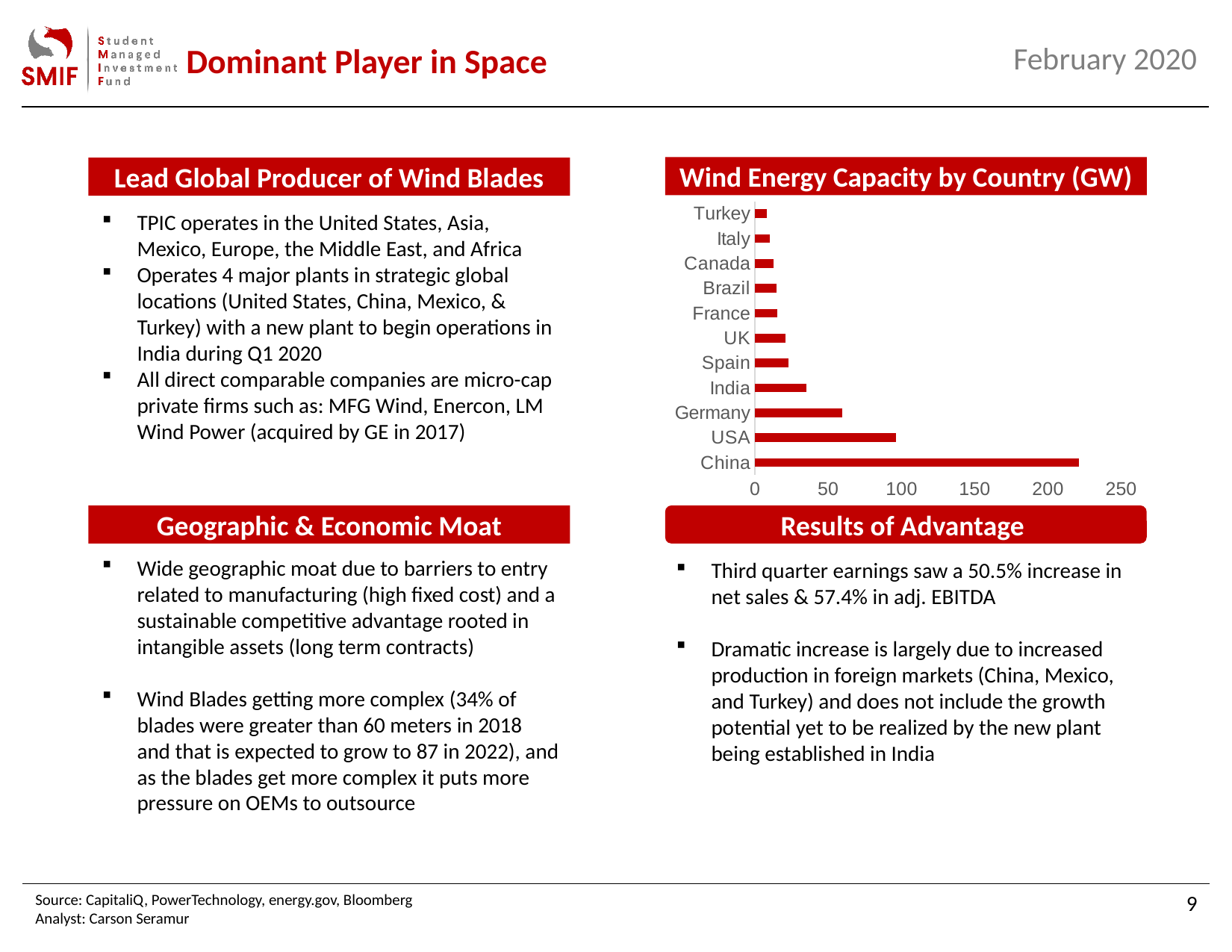
How many countries are shown in the Wind Energy Capacity by Country chart? 11 Is the wind energy capacity for Germany greater or less than 50? greater Which has a larger wind energy capacity, USA or Germany? USA What kind of chart is shown on the slide? bar chart Is the wind energy capacity for Spain greater or less than 50? less Is the wind energy capacity for USA greater or less than 50? greater What is the highest value shown on the horizontal axis of the chart? 250 What is the title of the chart on the slide? Wind Energy Capacity by Country (GW) Which country has the highest wind energy capacity in the chart? China Which has a larger wind energy capacity, India or Spain? India